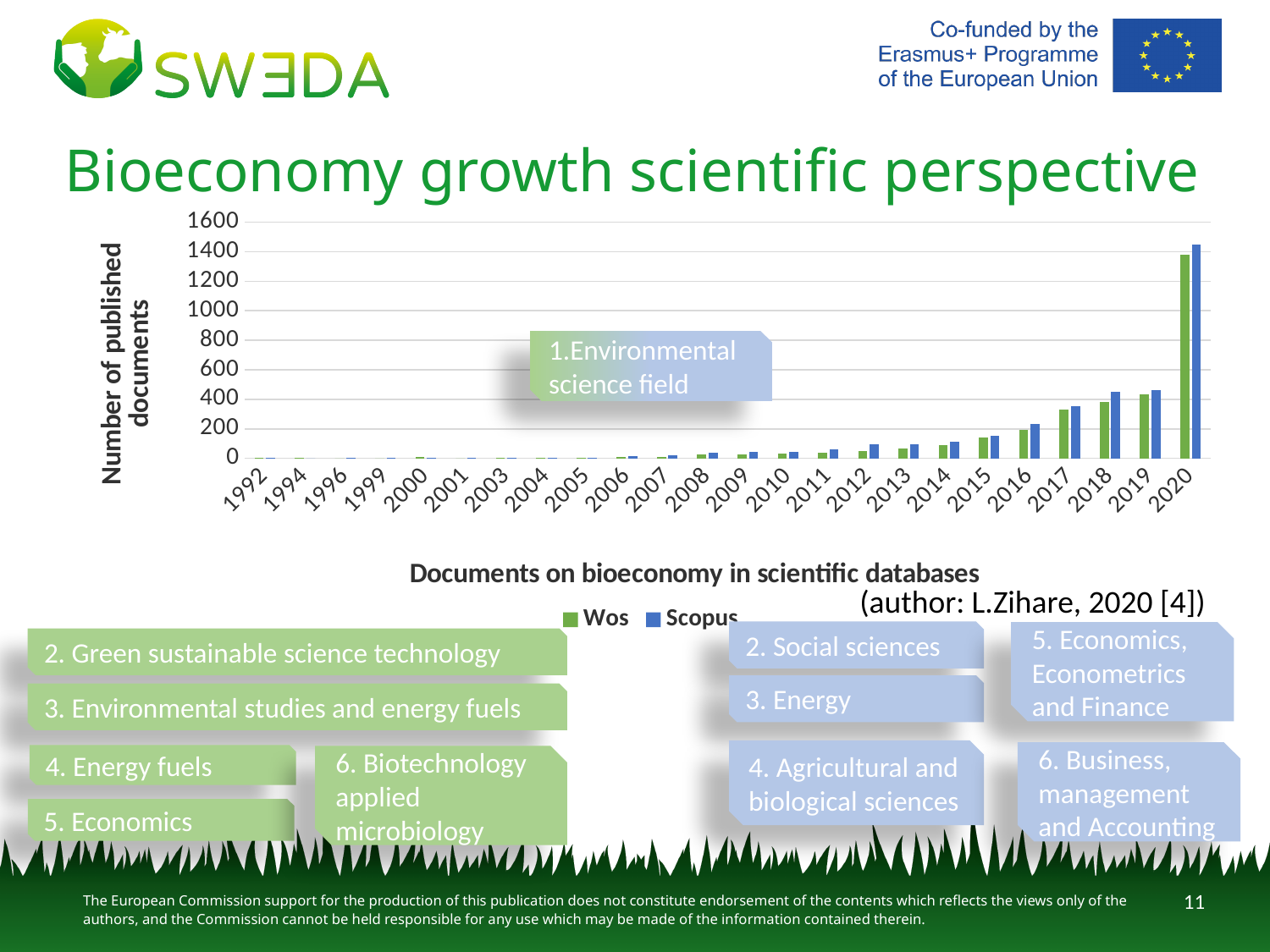
What is the title of the chart? Documents on bioeconomy in scientific databases What are the two series named in the chart legend? Wos and Scopus Which year has the highest number of published documents for Scopus? 2020 Is the Scopus value for 2016 greater or less than 200? greater Which is larger, the Scopus value for 2020 or the Scopus value for 2019? 2020 How many series does the legend of the chart list? 2 What kind of chart is shown on the slide? bar chart Is the Scopus value for 2020 greater or less than 1200? greater Which year has the highest number of published documents for Wos? 2020 Is the Wos value for 2017 greater or less than 400? less How many years are shown on the x axis of the chart? 24 Do the number of published documents generally rise or fall from 1992 to 2020? rise